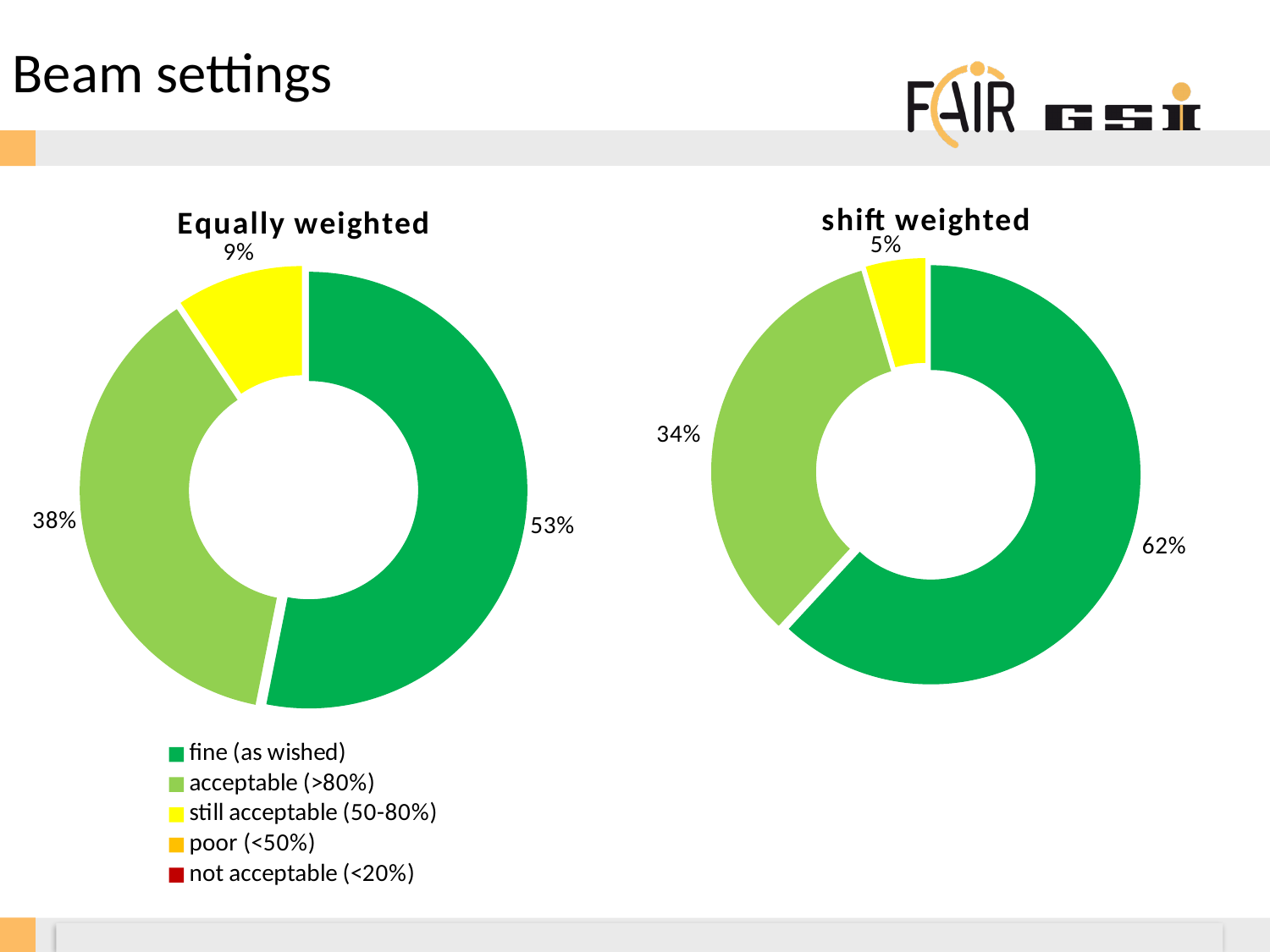
In the 'shift weighted' chart, what share is labelled for the 'still acceptable (50-80%)' slice? 5% In the 'Equally weighted' chart, which category has the largest slice? fine (as wished) In the 'shift weighted' chart, which category has the smallest slice? still acceptable (50-80%) Is the 'acceptable (>80%)' slice larger in the 'Equally weighted' chart or in the 'shift weighted' chart? Equally weighted In the 'shift weighted' chart, what share is labelled for the 'fine (as wished)' slice? 62% In the 'shift weighted' chart, what share is labelled for the 'acceptable (>80%)' slice? 34% In the 'Equally weighted' chart, what share is labelled for the 'acceptable (>80%)' slice? 38% What is the difference between the 'fine (as wished)' share in the 'shift weighted' chart and in the 'Equally weighted' chart? 9% In the 'Equally weighted' chart, what share is labelled for the 'fine (as wished)' slice? 53% In the 'Equally weighted' chart, what share is labelled for the 'still acceptable (50-80%)' slice? 9% How many categories does the legend list? 5 What kind of chart is the 'Equally weighted' chart? doughnut chart